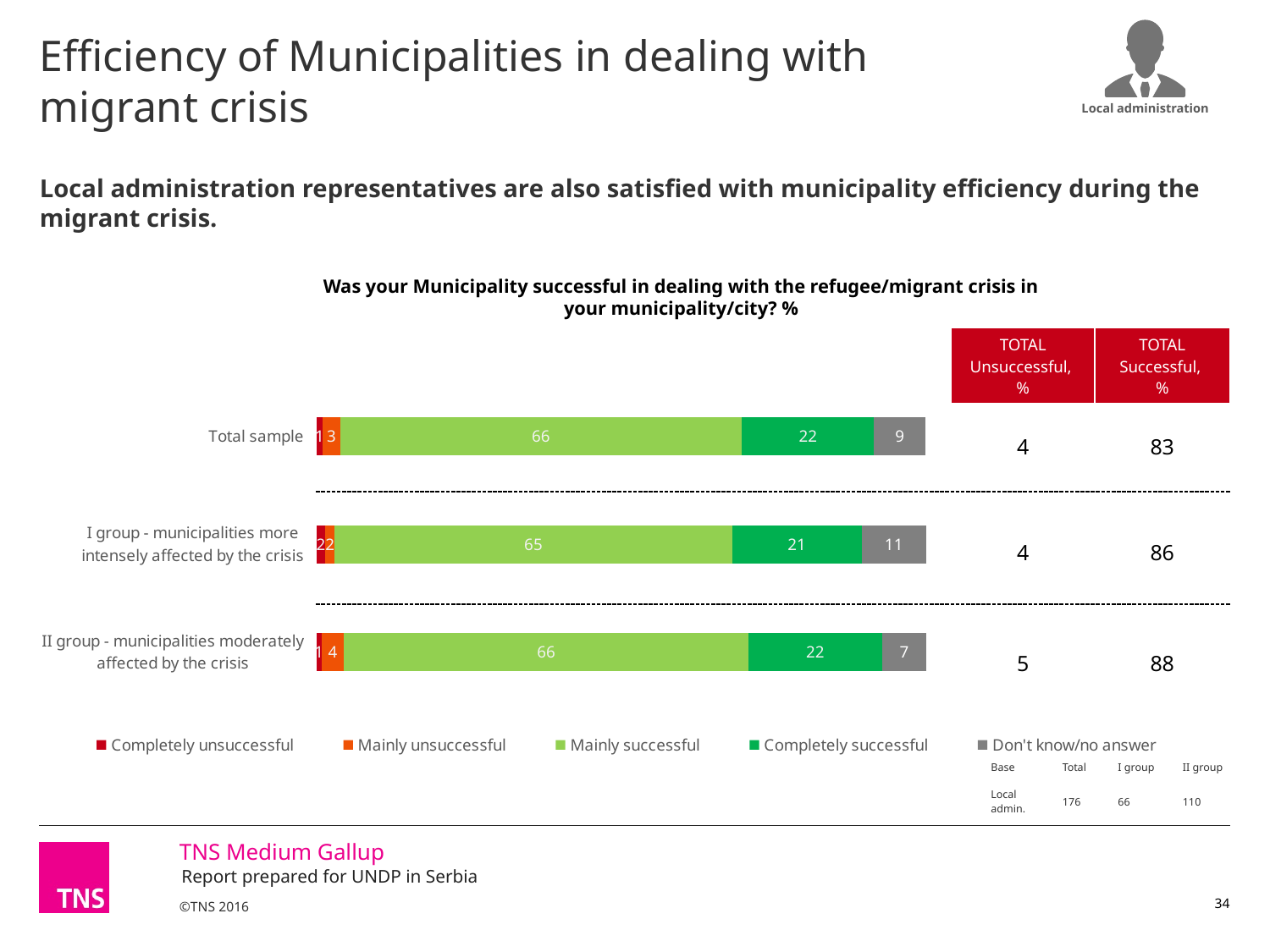
What type of chart is shown on the slide? Stacked bar chart How many categories (rows) are plotted in the chart? 3 What is the difference between the 'Don't know/no answer' values for the I group and the II group? 4 What is the TOTAL Successful % shown for the II group - municipalities moderately affected by the crisis? 88 Which category has the highest 'Don't know/no answer' value? I group - municipalities more intensely affected by the crisis Which category has the lowest 'Mainly successful' value? I group - municipalities more intensely affected by the crisis Is the 'Completely successful' value larger for the Total sample or for the I group? Total sample What is the 'Mainly successful' value for the Total sample? 66 How many series does the legend list? 5 What colour represents the 'Mainly successful' series in the legend? Light green What is the 'Don't know/no answer' value for the II group - municipalities moderately affected by the crisis? 7 What is the 'Completely successful' value for the I group - municipalities more intensely affected by the crisis? 21